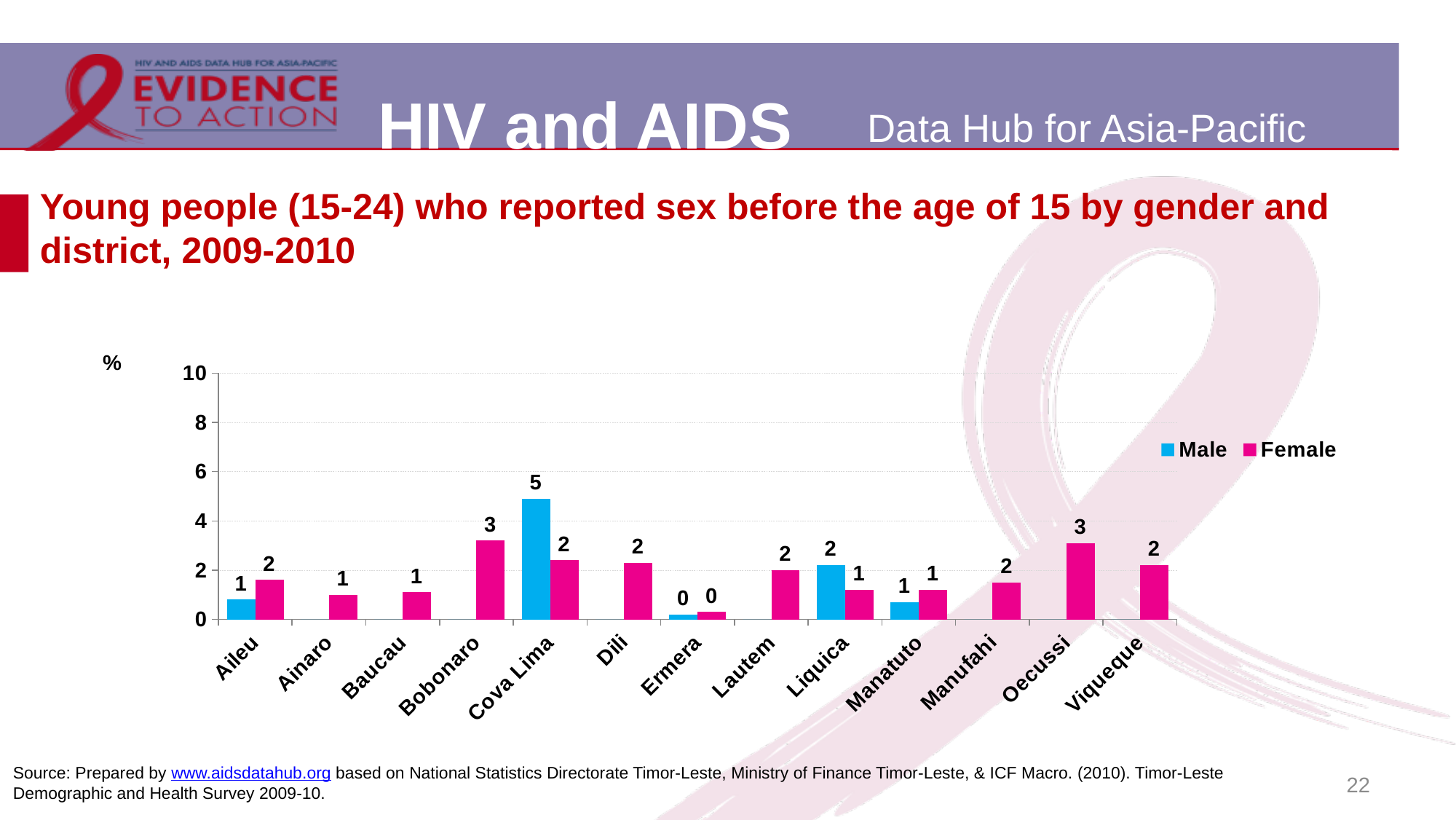
What is the Female value for Liquica? 1 Is the Male value for Cova Lima greater or less than 4? greater How many districts are shown on the x axis? 13 How many series does the legend list? 2 What unit is shown on the y axis? % Which district has the highest Male value? Cova Lima What is the Male value for Cova Lima? 5 What is the Female value for Bobonaro? 3 What type of chart is shown on the slide? bar chart For Liquica, which is larger, the Male value or the Female value? Male What is the difference between the Male and Female values for Cova Lima? 3 Which colour represents the Female series in the legend? pink